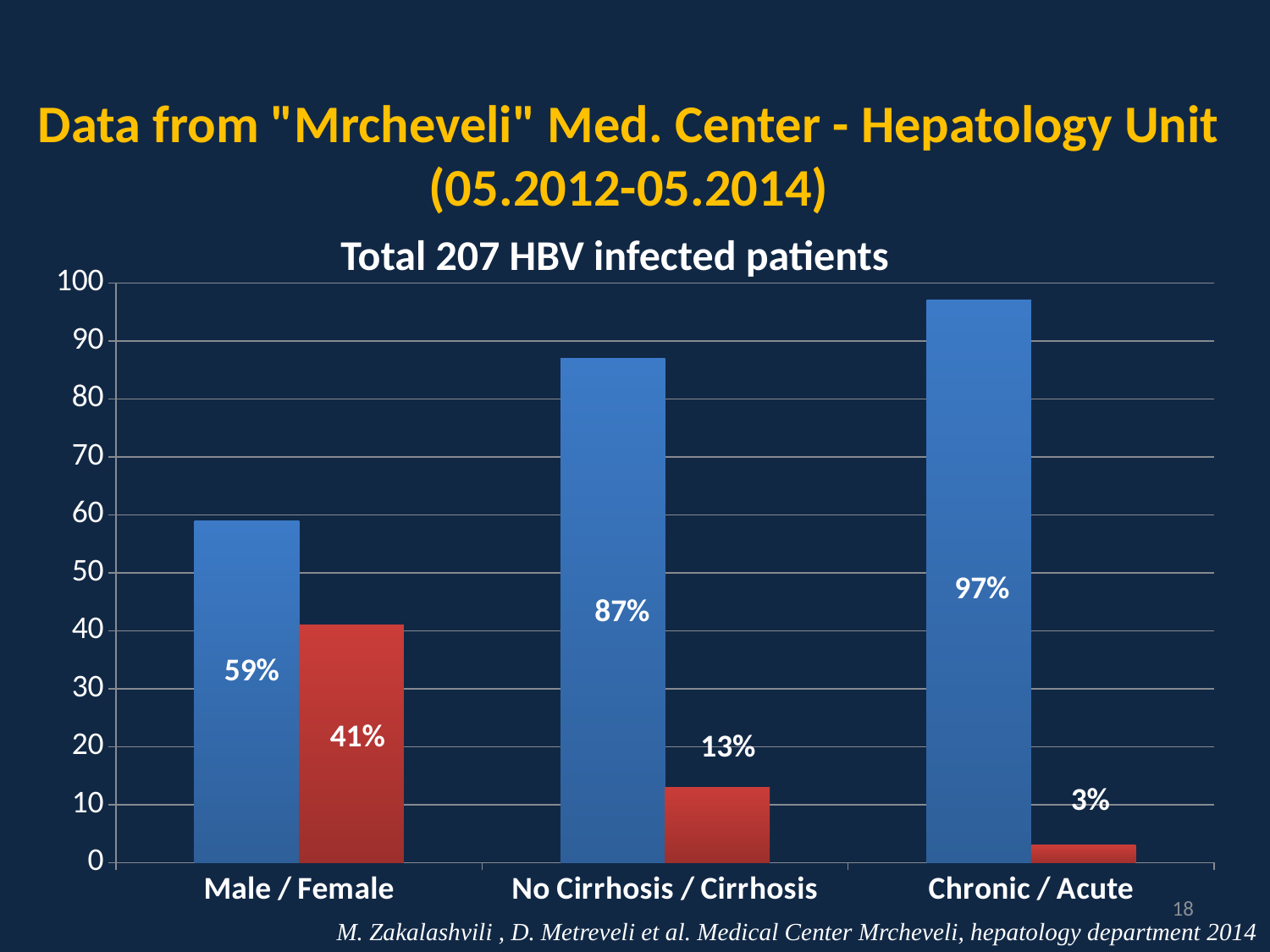
Which category has the shortest red bar? Chronic / Acute Which category has the tallest blue bar? Chronic / Acute What percentage is shown for the blue bar in the Male / Female category? 59% Is the value of the blue bar in the Male / Female category greater or less than 50? greater How many categories are shown on the x axis? 3 What is the difference between the blue and red bars in the No Cirrhosis / Cirrhosis category? 74% What percentage is shown for the blue bar in the No Cirrhosis / Cirrhosis category? 87% What is the title of the chart? Total 207 HBV infected patients Which is larger, the red bar for Male / Female or the red bar for No Cirrhosis / Cirrhosis? Male / Female What percentage is shown for the red bar in the Male / Female category? 41% What kind of chart is shown on the slide? Bar chart What percentage is shown for the red bar in the Chronic / Acute category? 3%